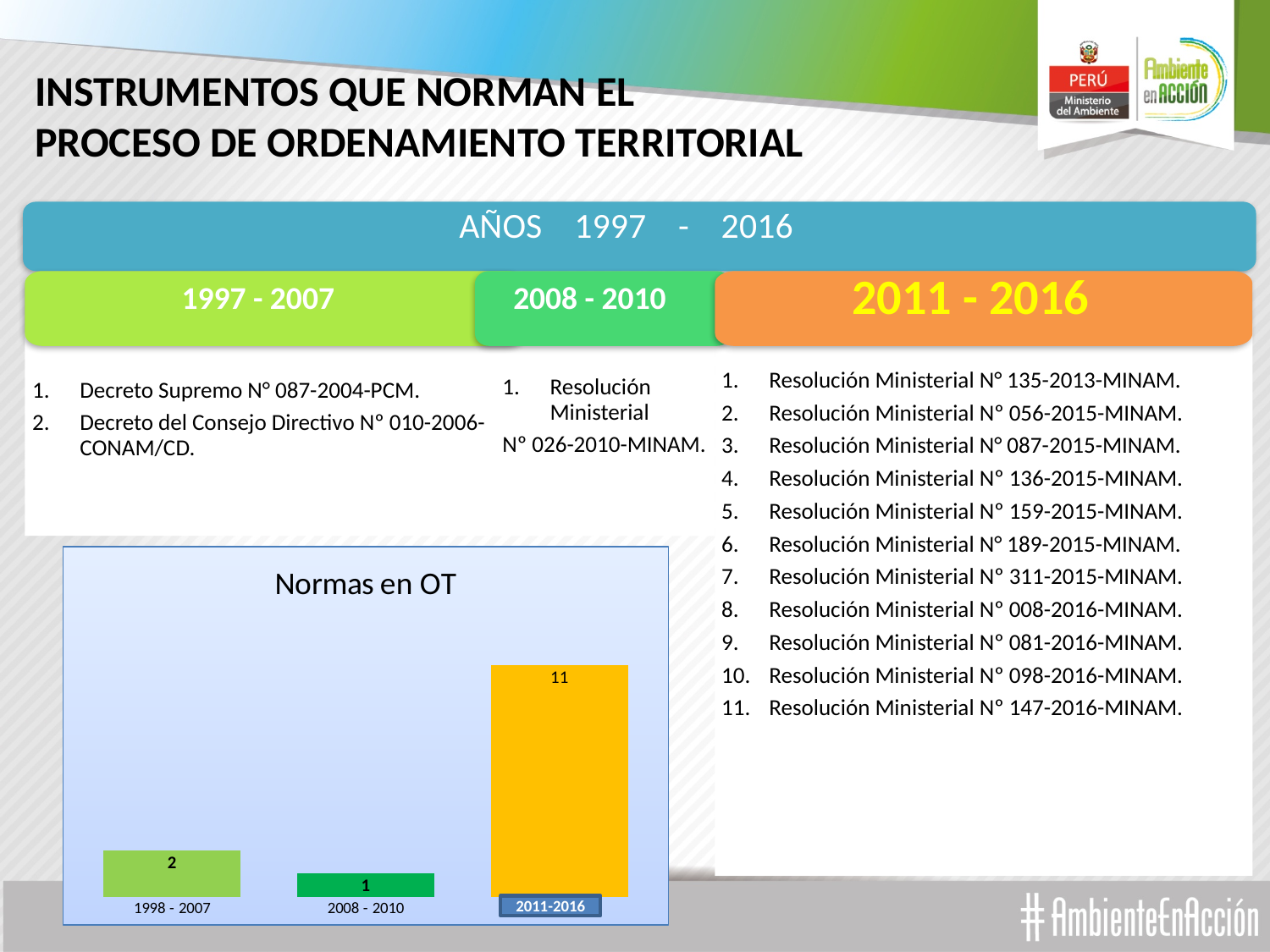
What is the title of the chart on the slide? Normas en OT Which is larger, the value for 1998 - 2007 or the value for 2008 - 2010? 1998 - 2007 What is the value for 2008 - 2010 in the chart? 1 What type of chart is shown on the slide? bar chart What is the total of the three values shown in the chart? 14 What is the value for 1998 - 2007 in the chart? 2 What is the difference between the values for 2011-2016 and 1998 - 2007? 9 What is the value for 2011-2016 in the chart? 11 Which category has the highest value in the chart? 2011-2016 What colour is the bar for 2011-2016? yellow/orange How many categories are shown in the chart? 3 Which category has the lowest value in the chart? 2008 - 2010